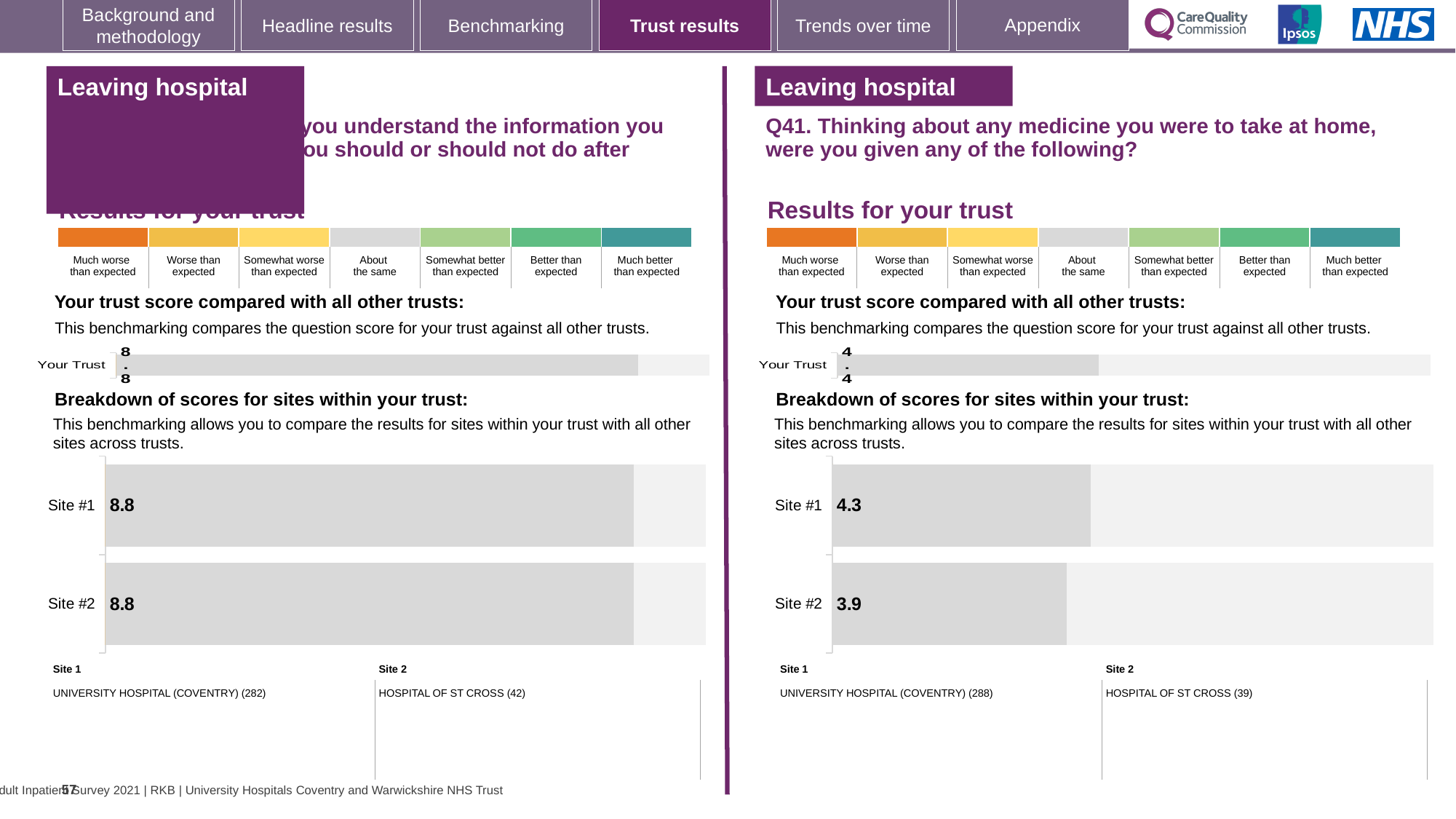
On the right-hand chart (Q41), what is the score shown for Your Trust? 4.4 On the left-hand chart, what is the score for Site #1? 8.8 On the right-hand chart (Q41), which site has the lowest score? Site #2 On the right-hand chart (Q41), what is the difference between the Site #1 and Site #2 scores? 0.4 On the left-hand chart, what is the score for Site #2? 8.8 On the right-hand chart (Q41), what is the score for Site #1? 4.3 How many sites are shown in the site breakdown chart on the right-hand side (Q41)? 2 On the right-hand chart (Q41), what is the score for Site #2? 3.9 What type of chart is used for the breakdown of scores for sites on the left-hand side? Bar chart On the right-hand chart (Q41), which site has the higher score, Site #1 or Site #2? Site #1 On the right-hand chart (Q41), what is the difference between the Your Trust score and the Site #2 score? 0.5 On the left-hand chart, what is the score shown for Your Trust? 8.8